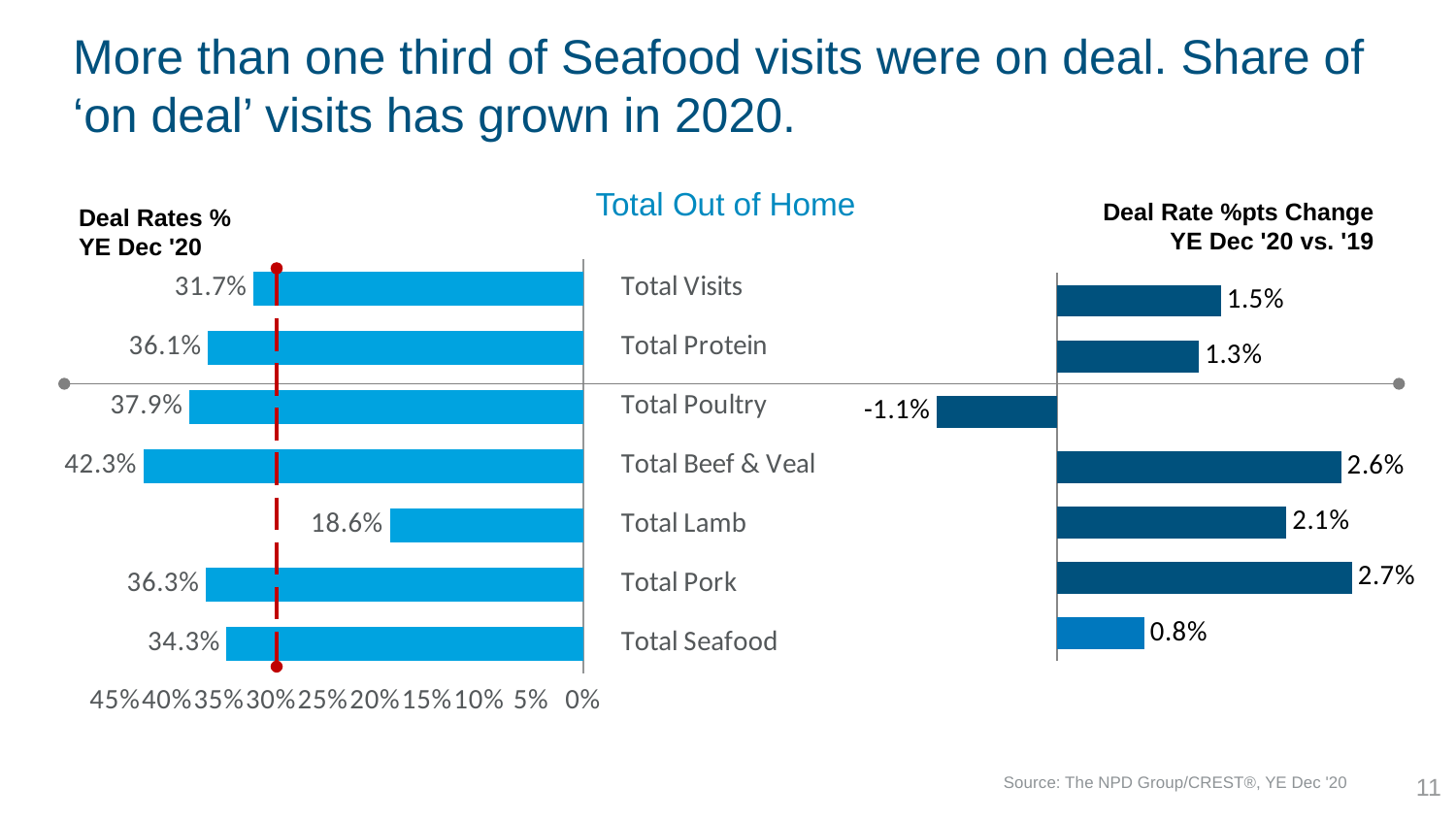
In the 'Deal Rates % YE Dec '20' chart, what is the deal rate for Total Seafood? 34.3% In the 'Deal Rate %pts Change YE Dec '20 vs. '19' chart, which category is the only one with a negative change? Total Poultry In the 'Deal Rate %pts Change YE Dec '20 vs. '19' chart, what is the value for Total Poultry? -1.1% In the 'Deal Rates % YE Dec '20' chart, what is the deal rate for Total Beef & Veal? 42.3% In the 'Deal Rate %pts Change YE Dec '20 vs. '19' chart, what is the value for Total Seafood? 0.8% In the 'Deal Rates % YE Dec '20' chart, which category has the highest deal rate? Total Beef & Veal In the 'Deal Rates % YE Dec '20' chart, which has a higher deal rate, Total Poultry or Total Protein? Total Poultry How many categories are shown in the 'Deal Rates % YE Dec '20' chart? 7 In the 'Deal Rates % YE Dec '20' chart, what is the difference between the deal rates for Total Pork and Total Lamb? 17.7% In the 'Deal Rates % YE Dec '20' chart, which category has the lowest deal rate? Total Lamb In the 'Deal Rate %pts Change YE Dec '20 vs. '19' chart, which category has the largest change? Total Pork What type of chart is the 'Deal Rate %pts Change YE Dec '20 vs. '19' chart? Bar chart